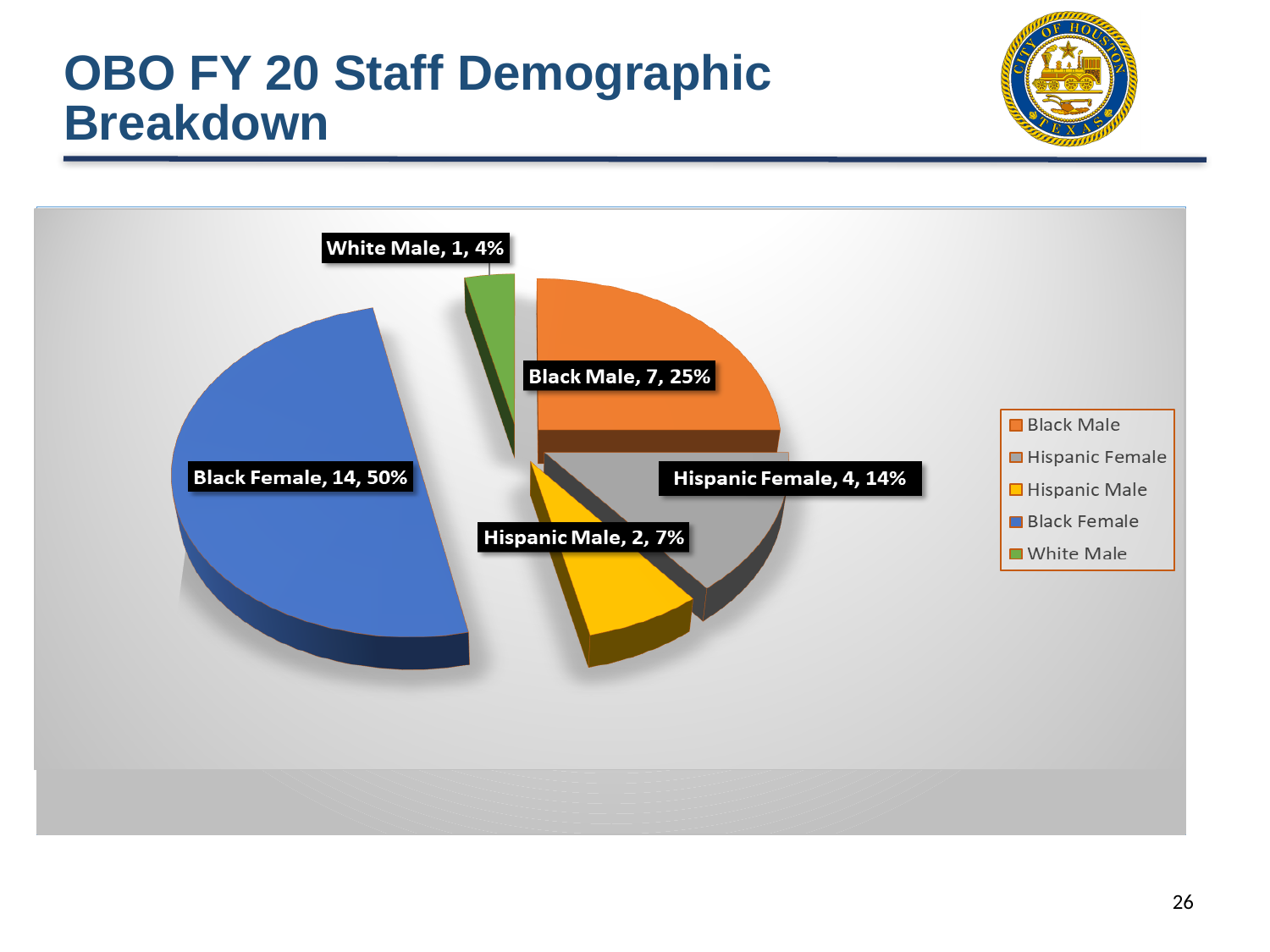
What is the difference in staff count between Black Female and Black Male? 7 What is the total number of staff across all slices of the pie? 28 How many staff are Hispanic Female? 4 Which is larger, the Hispanic Female count or the Hispanic Male count? Hispanic Female Which demographic category has the largest slice of the pie? Black Female What percentage share does the White Male slice represent? 4% What type of chart is shown on the slide? Pie chart How many staff are Black Female according to the chart? 14 How many demographic categories are shown in the pie chart? 5 What percentage of staff are Black Male? 25% Which demographic category has the smallest slice of the pie? White Male What colour is the Hispanic Male slice? Yellow